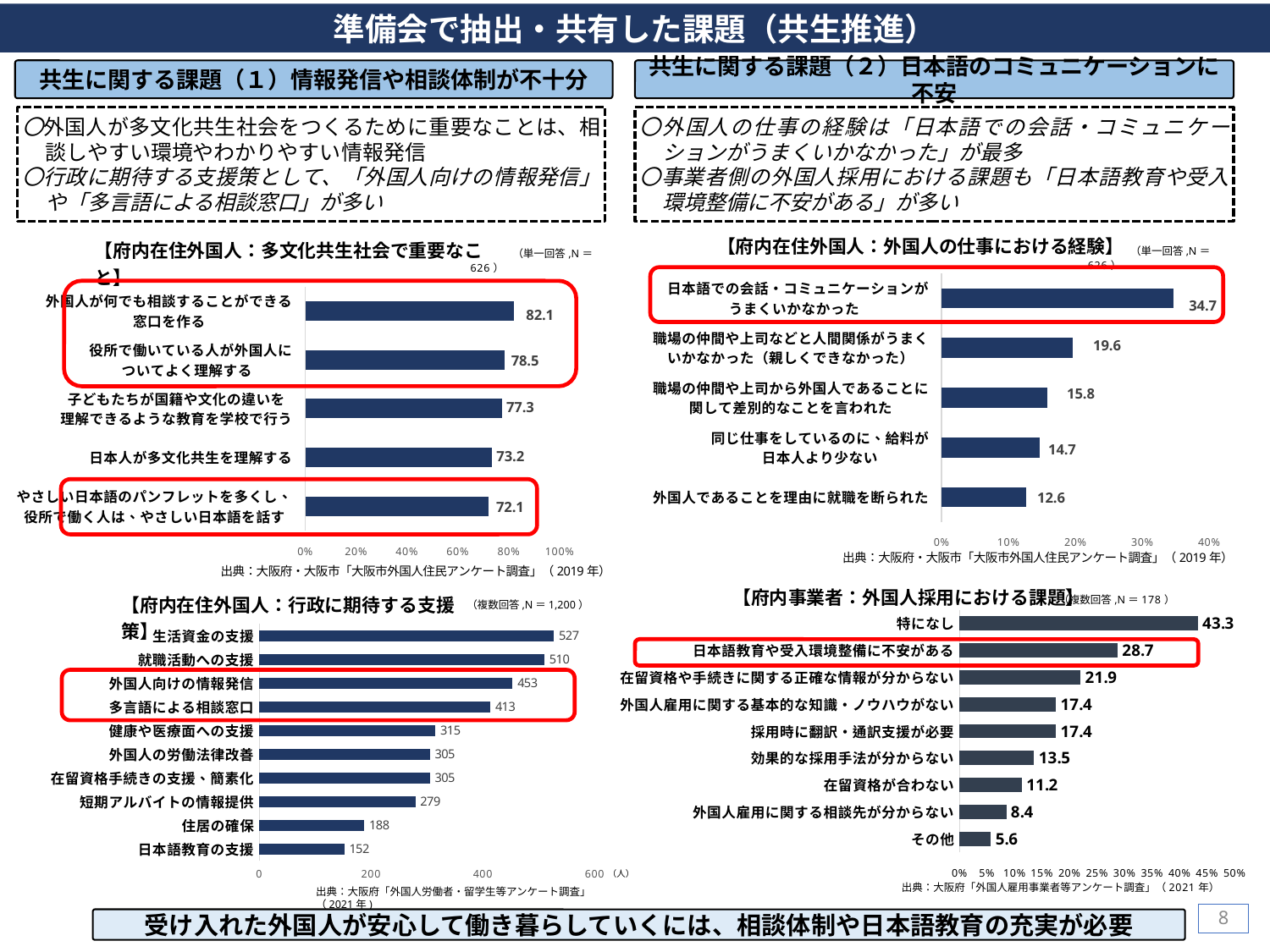
「府内在住外国人：行政に期待する支援策」のグラフで、「生活資金の支援」と「就職活動への支援」ではどちらが大きいですか？ 生活資金の支援 「府内在住外国人：外国人の仕事における経験」のグラフで、最も値が高い項目はどれですか？ 日本語での会話・コミュニケーションがうまくいかなかった 「府内事業者：外国人採用における課題」のグラフで、「日本語教育や受入環境整備に不安がある」の値はいくつですか？ 28.7 「府内事業者：外国人採用における課題」のグラフで、最も値が低い項目はどれですか？ その他 「府内在住外国人：多文化共生社会で重要なこと」のグラフで、最も値が低い項目はどれですか？ やさしい日本語のパンフレットを多くし、役所で働く人は、やさしい日本語を話す 「府内在住外国人：外国人の仕事における経験」のグラフで、「外国人であることを理由に就職を断られた」の値はいくつですか？ 12.6 「府内在住外国人：多文化共生社会で重要なこと」のグラフで、「外国人が何でも相談することができる窓口を作る」の値はいくつですか？ 82.1 「府内事業者：外国人採用における課題」のグラフはどの種類のグラフですか？ 棒グラフ 「府内在住外国人：外国人の仕事における経験」のグラフで、「日本語での会話・コミュニケーションがうまくいかなかった」と「職場の仲間や上司などと人間関係がうまくいかなかった」の差はいくつですか？ 15.1 「府内在住外国人：多文化共生社会で重要なこと」のグラフには、いくつの項目がありますか？ 5 「府内在住外国人：行政に期待する支援策」のグラフで、「外国人向けの情報発信」の値はいくつですか？ 453 「府内在住外国人：行政に期待する支援策」のグラフには、いくつの項目がありますか？ 10